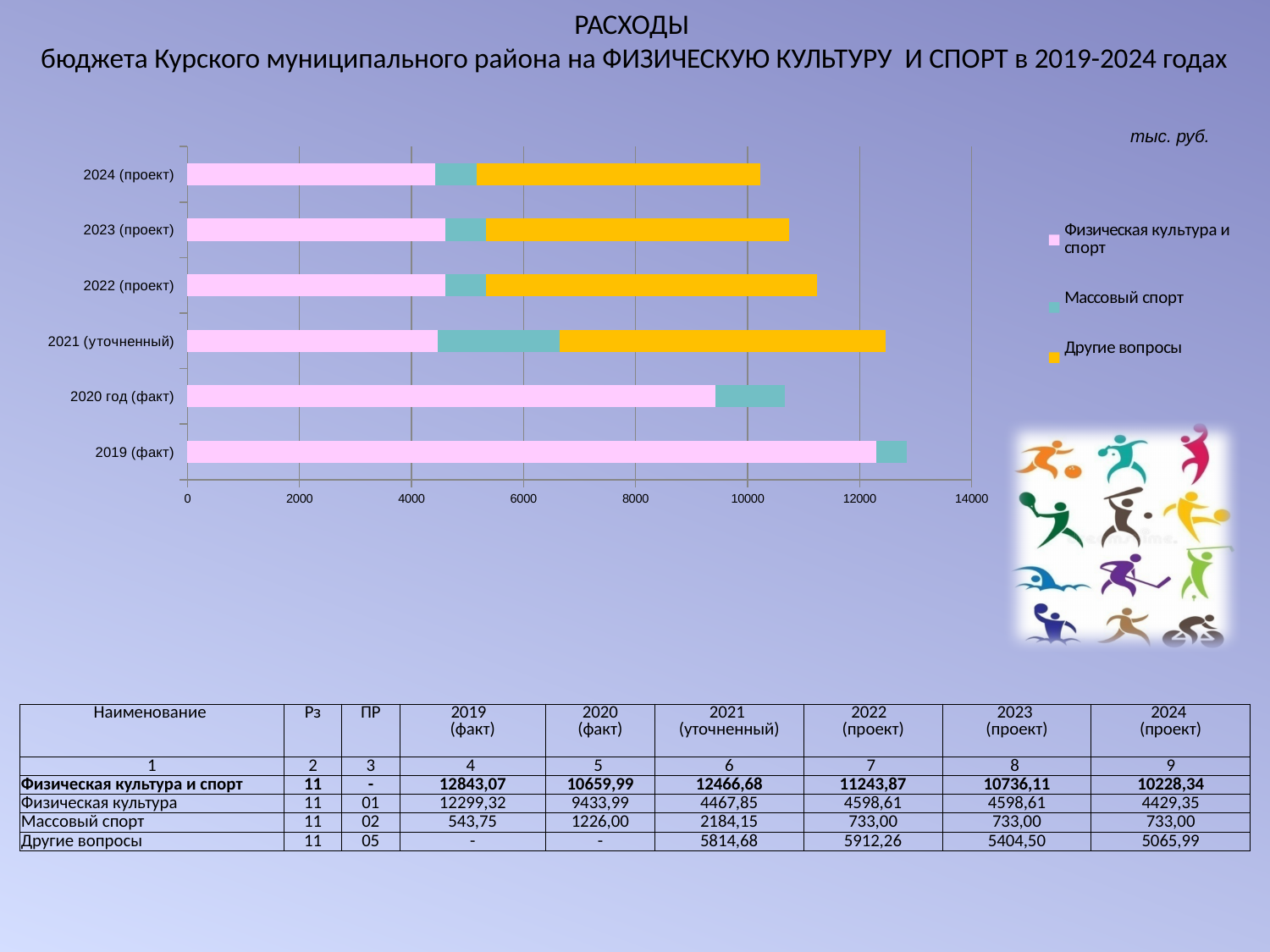
Is the Массовый спорт segment larger for 2021 (уточненный) or for 2020 год (факт)? 2021 (уточненный) Which series is shown in yellow in the chart legend? Другие вопросы According to the table on the slide, what is the value for Массовый спорт in 2021 (уточненный)? 2184,15 Is the total length of the stacked bar for 2021 (уточненный) greater or less than 12000? greater Which year has the largest total stacked bar on the chart? 2019 (факт) Is the total length of the stacked bar for 2020 год (факт) greater or less than 10000? greater Is the value of the pink 'Физическая культура и спорт' segment for 2019 (факт) greater or less than 12000? greater Using the totals in the table, what is the difference between the 2019 (факт) total for Физическая культура и спорт and the 2020 (факт) total? 2183,08 According to the table on the slide, what is the value for Другие вопросы in 2022 (проект)? 5912,26 How many year categories are plotted on the chart? 6 What kind of chart is shown on the slide? Stacked bar chart How many series does the chart legend list? 3